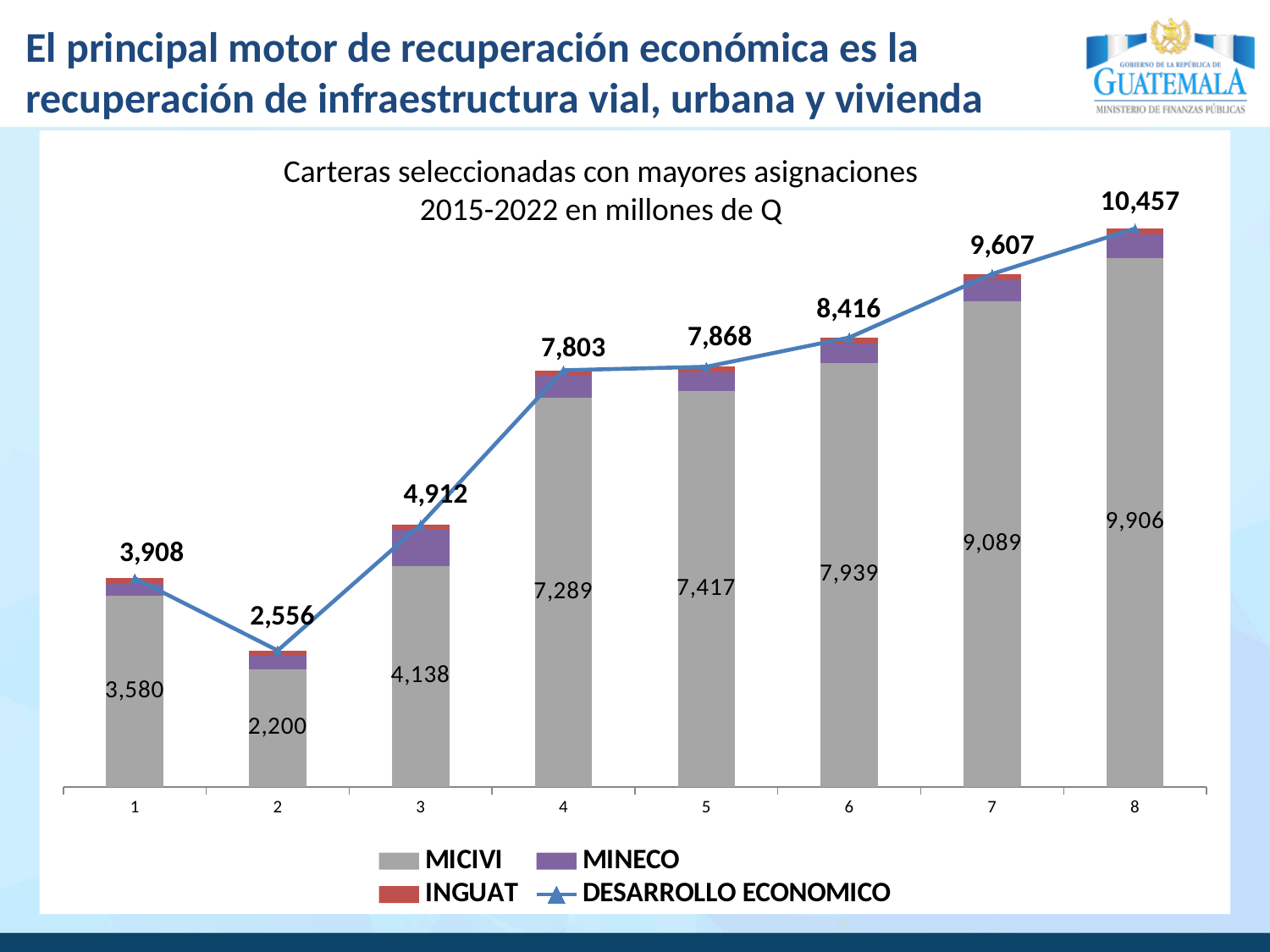
What is the DESARROLLO ECONOMICO value for category 2? 2,556 Does the DESARROLLO ECONOMICO line rise or fall from category 3 to category 8? rise Which category has the lowest MICIVI value? 2 What kind of chart is this? Stacked bar chart with a line What is the difference between the MICIVI values for category 5 and category 4? 128 Which is larger, the MICIVI value for category 1 or for category 2? category 1 How many series does the legend list? 4 How many categories are shown on the x axis? 8 What is the difference between the DESARROLLO ECONOMICO values for category 8 and category 7? 850 Which category has the highest DESARROLLO ECONOMICO value? 8 What is the MICIVI value for category 8? 9,906 What is the MICIVI value for category 3? 4,138